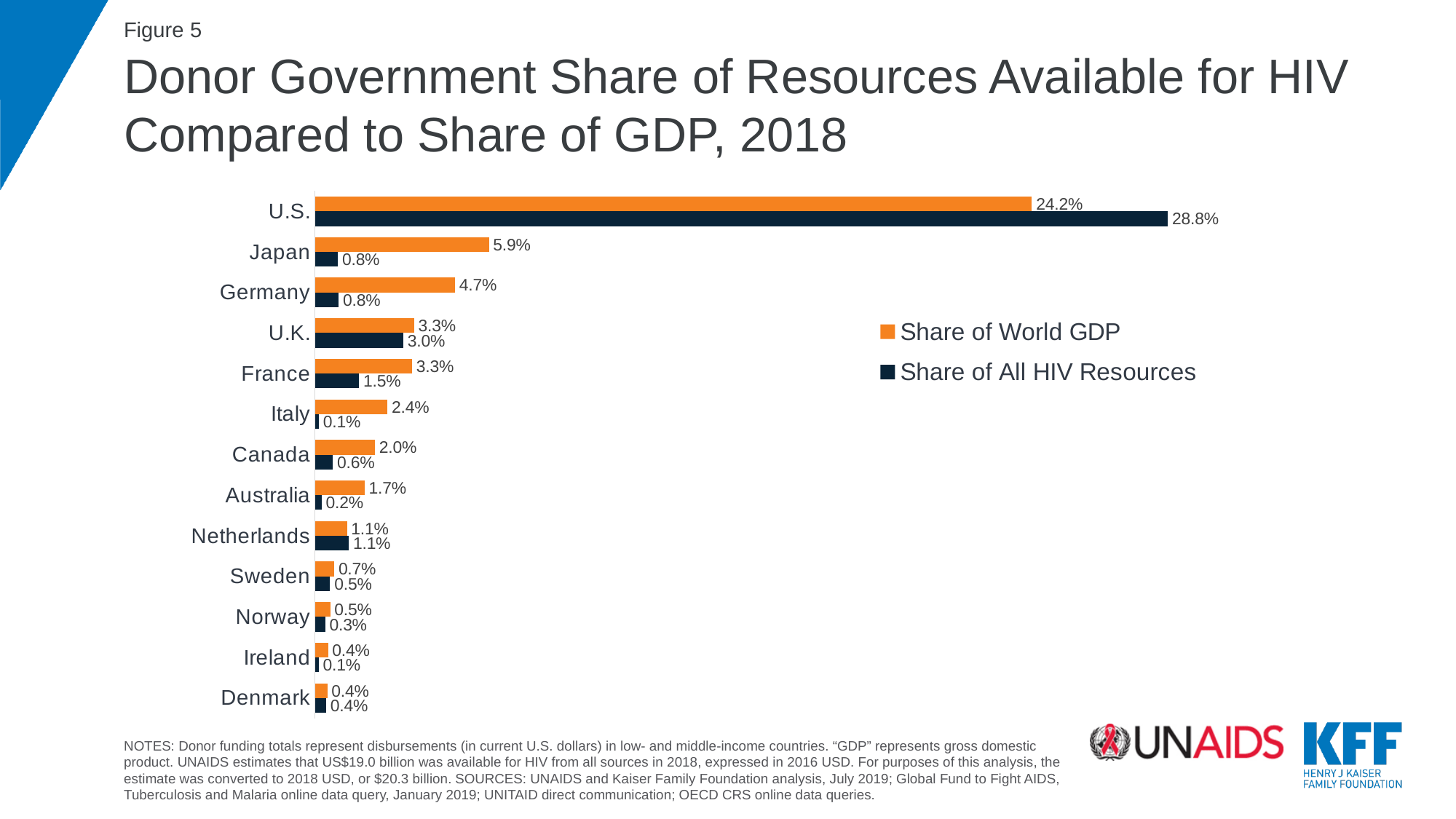
What is the U.S. Share of All HIV Resources? 28.8% Which colour represents Share of All HIV Resources in the chart? Dark navy Which is larger for Germany: Share of World GDP or Share of All HIV Resources? Share of World GDP Which country has the lowest Share of World GDP? Denmark and Ireland (0.4%) How many countries are shown in the chart? 13 What kind of chart is shown on the slide? Bar chart How many series does the legend list? 2 What is France's Share of All HIV Resources? 1.5% What is the difference between the U.S. Share of All HIV Resources and its Share of World GDP? 4.6 percentage points What is Japan's Share of World GDP? 5.9% Which country has the highest Share of World GDP? U.S. Which is larger: the U.K.'s Share of All HIV Resources or Canada's Share of All HIV Resources? U.K.'s Share of All HIV Resources